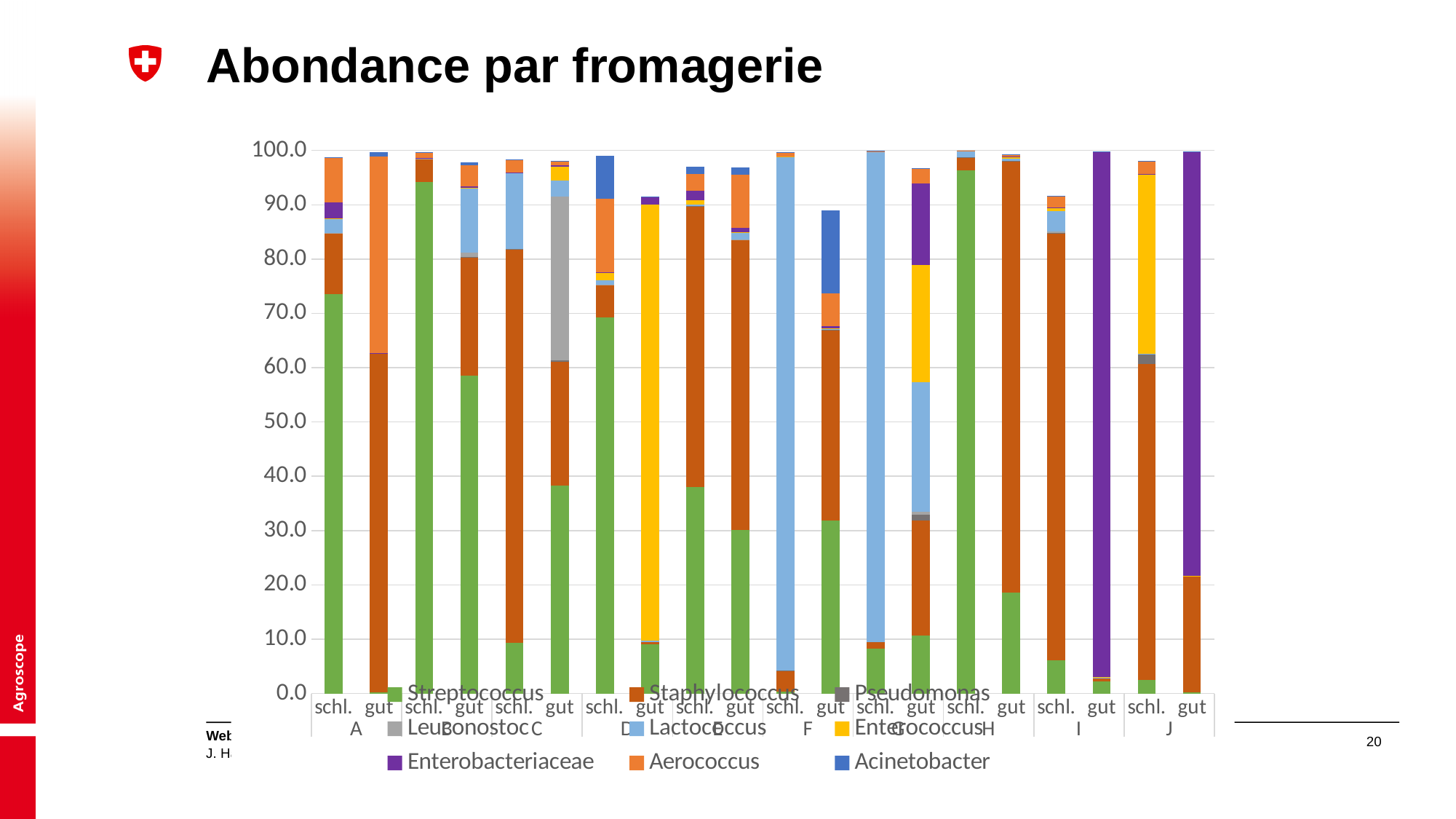
How many bars are plotted in the chart? 20 How many fromageries (letter groups) are shown on the x axis? 10 Is the Streptococcus value for H schl. greater or less than 90? greater Is the Streptococcus value for A schl. greater or less than 60? greater Is the Leuconostoc value for C gut greater or less than 20? greater Which has the larger Streptococcus value, H schl. or H gut? H schl. How many series does the legend list? 9 What is the title of the chart? Abondance par fromagerie What kind of chart is shown on the slide? Stacked bar chart